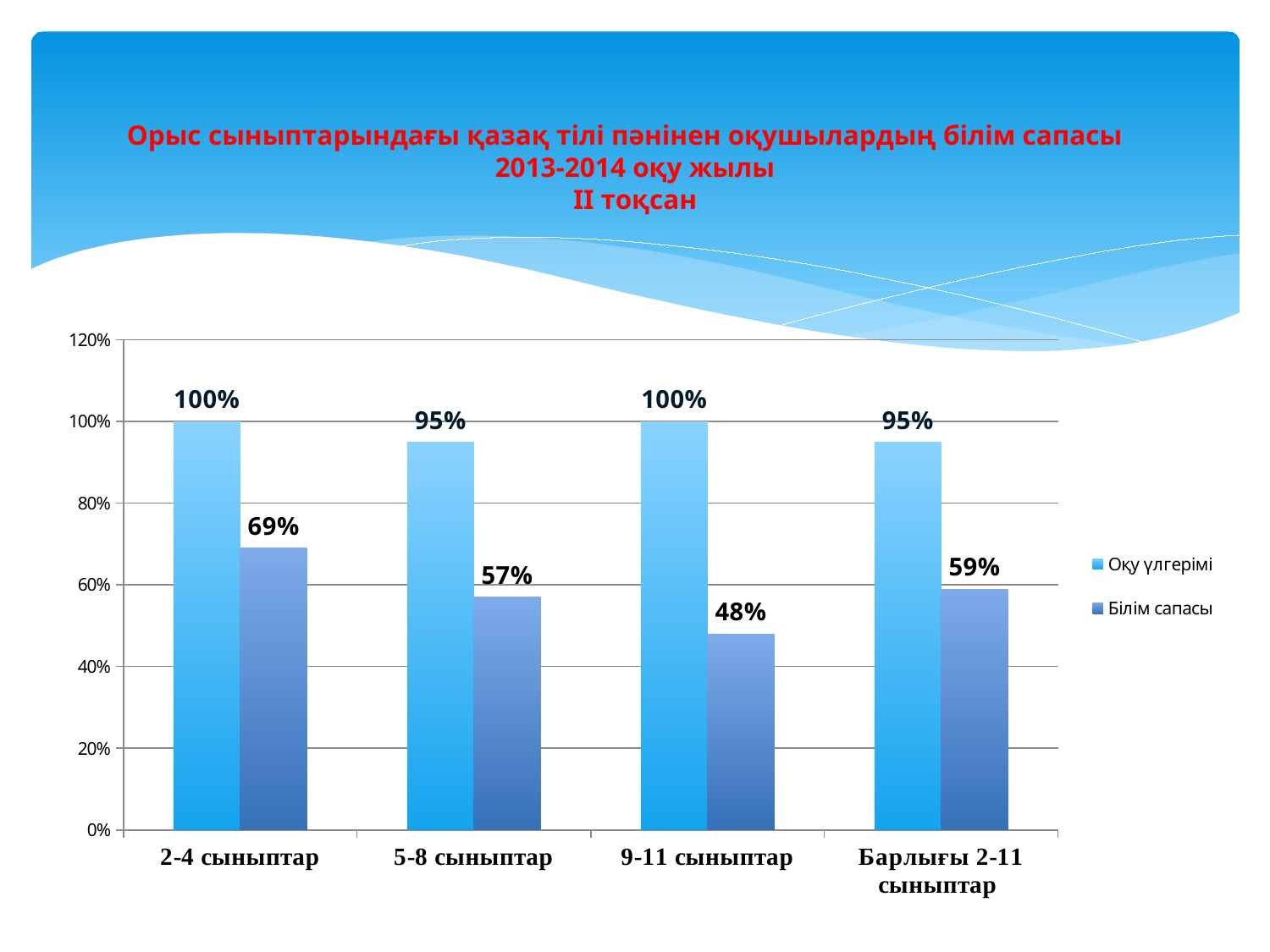
What is the value of Білім сапасы for 2-4 сыныптар? 69% What is the value of Білім сапасы for Барлығы 2-11 сыныптар? 59% How many categories are shown on the x axis? 4 What kind of chart is shown on the slide? Bar chart What is the value of Білім сапасы for 9-11 сыныптар? 48% Which is larger: Білім сапасы for 5-8 сыныптар or for Барлығы 2-11 сыныптар? Барлығы 2-11 сыныптар Which series is shown in light blue in the legend? Оқу үлгерімі Which category has the highest Білім сапасы value? 2-4 сыныптар What is the difference between Оқу үлгерімі and Білім сапасы for 9-11 сыныптар? 52% What is the value of Оқу үлгерімі for 5-8 сыныптар? 95% Which category has the lowest Білім сапасы value? 9-11 сыныптар How many series does the legend list? 2